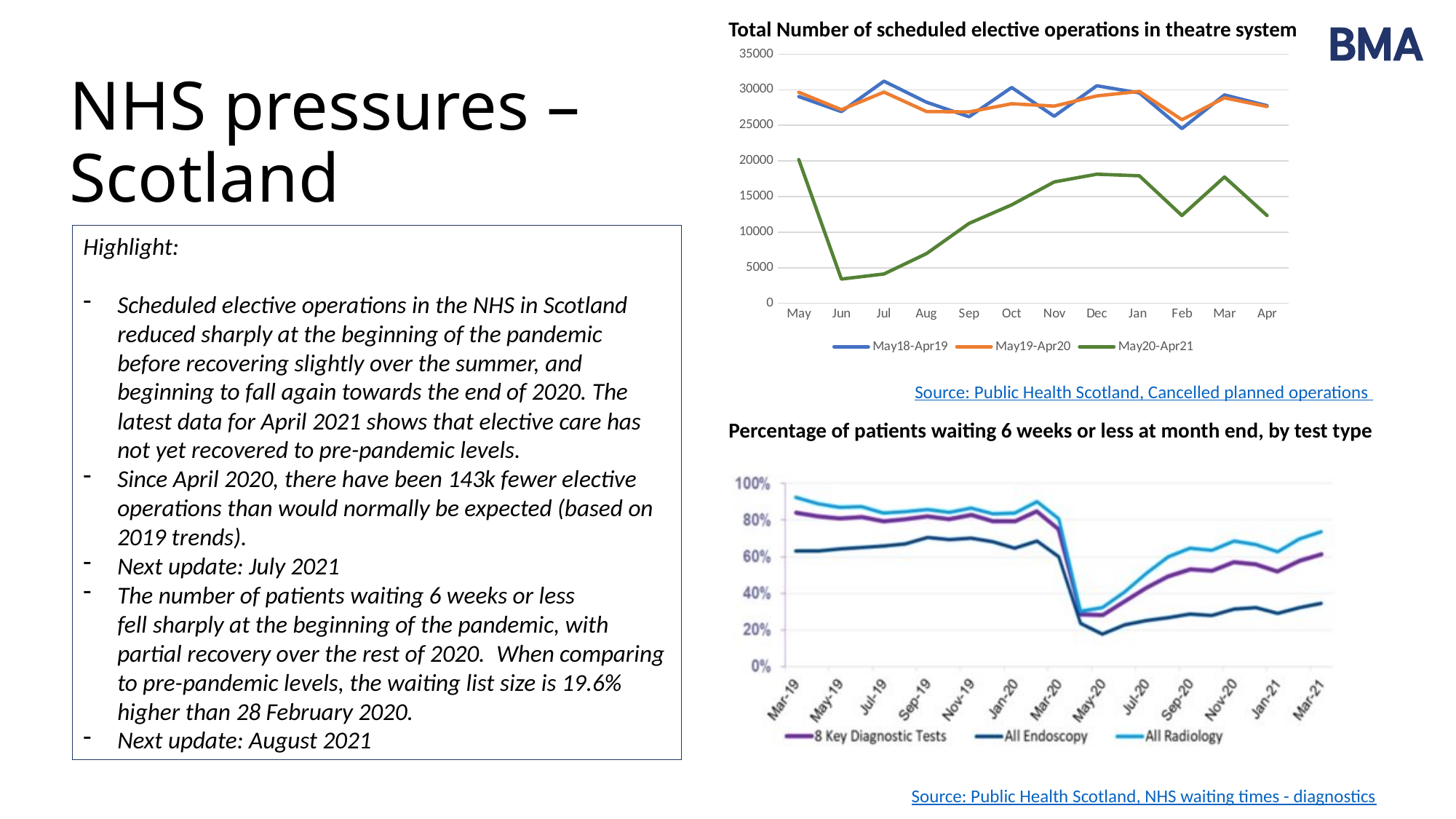
How many series does the legend of the top chart, 'Total Number of scheduled elective operations in theatre system', list? 3 In the bottom chart, 'Percentage of patients waiting 6 weeks or less at month end, by test type', at which month label is the All Endoscopy series lowest? May-20 How many series does the legend of the bottom chart, 'Percentage of patients waiting 6 weeks or less at month end, by test type', list? 3 In the bottom chart, 'Percentage of patients waiting 6 weeks or less at month end, by test type', is the All Endoscopy value for May-20 greater or less than 20%? less In the top chart, 'Total Number of scheduled elective operations in theatre system', does the May20-Apr21 series rise or fall from Jun to Dec? rise How many months are shown on the x axis of the top chart, 'Total Number of scheduled elective operations in theatre system'? 12 In the top chart, 'Total Number of scheduled elective operations in theatre system', in which month is the May20-Apr21 series lowest? Jun In the top chart, 'Total Number of scheduled elective operations in theatre system', is the May20-Apr21 value for Jun greater or less than 5000? less In the bottom chart, 'Percentage of patients waiting 6 weeks or less at month end, by test type', which series is higher at Mar-21: All Radiology or All Endoscopy? All Radiology What kind of chart is the top chart, 'Total Number of scheduled elective operations in theatre system'? line chart In the top chart, 'Total Number of scheduled elective operations in theatre system', is the May20-Apr21 value for Dec greater or less than 15000? greater In the top chart, 'Total Number of scheduled elective operations in theatre system', which series has the lowest values across the year? May20-Apr21